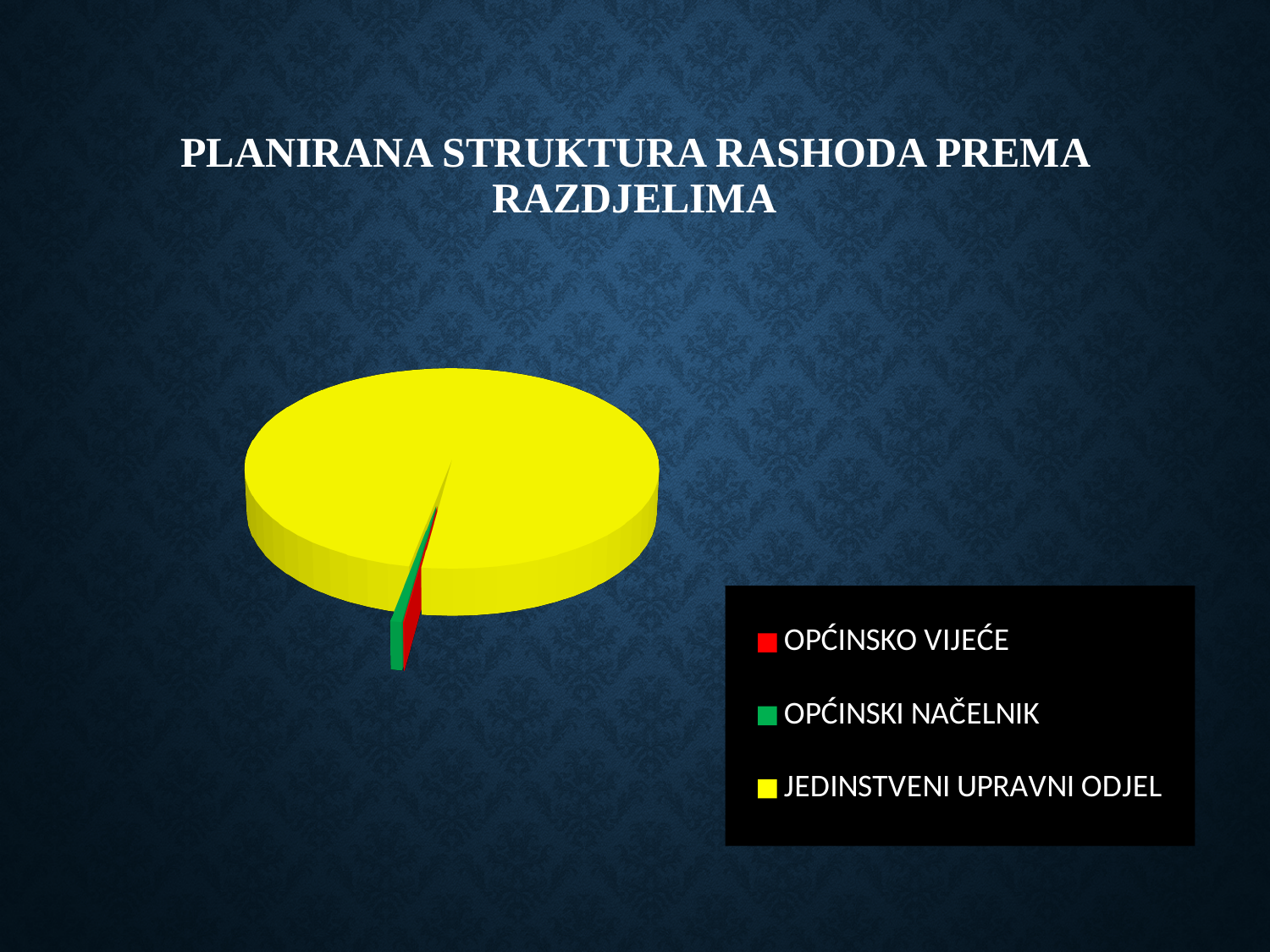
Which is larger, the slice for OPĆINSKI NAČELNIK or the slice for JEDINSTVENI UPRAVNI ODJEL? JEDINSTVENI UPRAVNI ODJEL What kind of chart is shown on the slide? Pie chart Which category has the largest slice of the pie? JEDINSTVENI UPRAVNI ODJEL What colour represents OPĆINSKI NAČELNIK in the pie chart? Green How many slices does the pie chart have? 3 Which is larger, the slice for JEDINSTVENI UPRAVNI ODJEL or the slice for OPĆINSKO VIJEĆE? JEDINSTVENI UPRAVNI ODJEL What is the title of the chart? PLANIRANA STRUKTURA RASHODA PREMA RAZDJELIMA How many entries does the legend list? 3